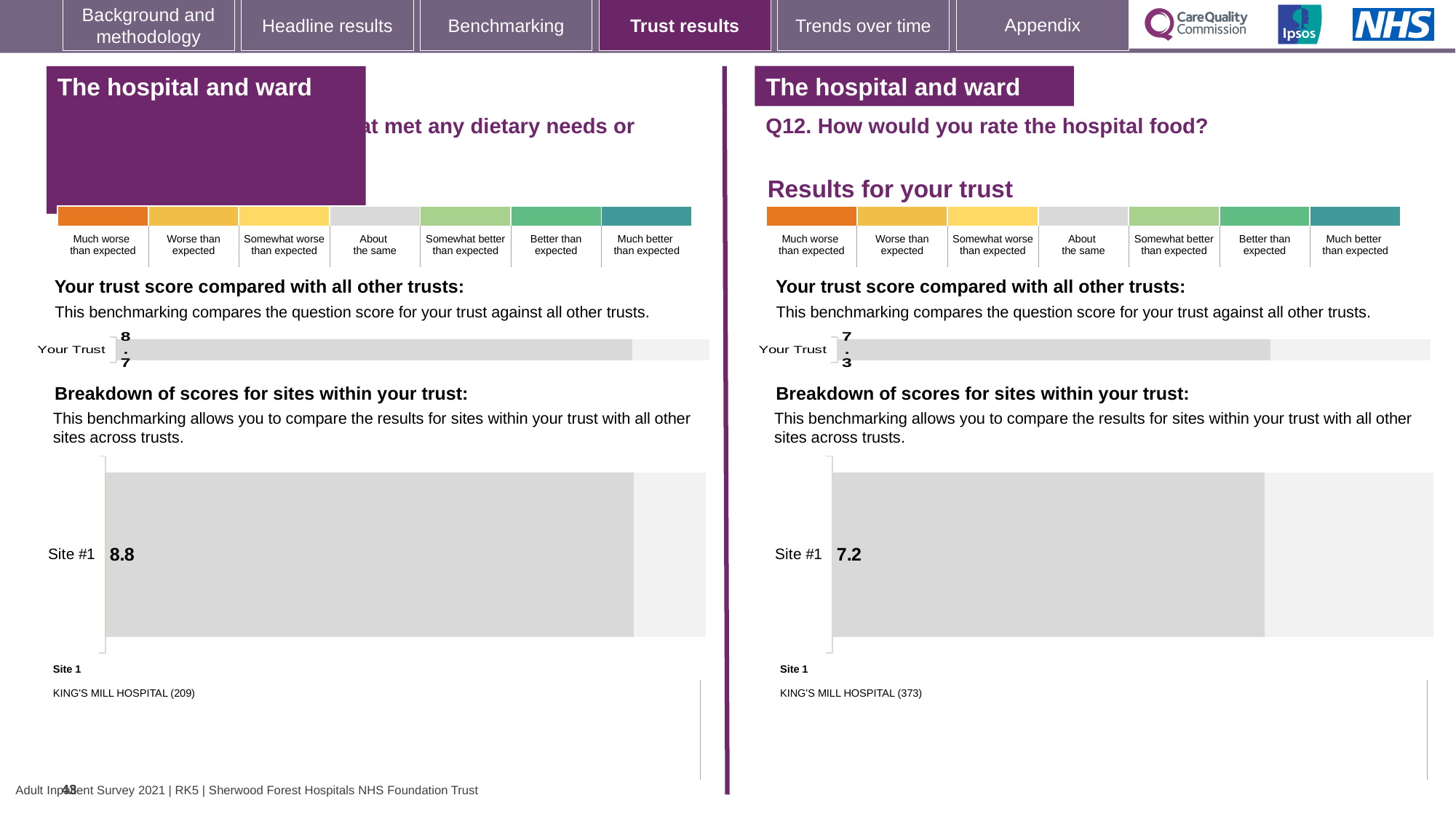
On the right half of the slide (Q12), is the Site #1 score greater or less than the 'Your Trust' score? less Which is larger: the Site #1 score on the left half of the slide or the Site #1 score on the right half (Q12)? Left half (8.8) What type of chart is used to show the Site #1 score on the right half of the slide (Q12)? Bar chart On the right half of the slide (Q12, hospital food), what score is shown for Site #1? 7.2 On the left half of the slide, which site name is listed as Site 1 below the chart? KING'S MILL HOSPITAL (209) What is the difference between the Site #1 score on the left half of the slide (8.8) and the Site #1 score on the right half (7.2)? 1.6 On the right half of the slide (Q12), which site name is listed as Site 1 below the chart? KING'S MILL HOSPITAL (373) On the right half of the slide (Q12, hospital food), what is the 'Your Trust' score shown in the trust benchmarking bar? 7.3 What is the difference between the 'Your Trust' score on the left half of the slide (8.7) and the 'Your Trust' score on the right half (7.3)? 1.4 On the left half of the slide, what score is shown for Site #1 in the breakdown of scores for sites? 8.8 How many sites are shown in the breakdown of scores on the right half of the slide (Q12)? 1 On the left half of the slide, what is the 'Your Trust' score shown in the trust benchmarking bar? 8.7